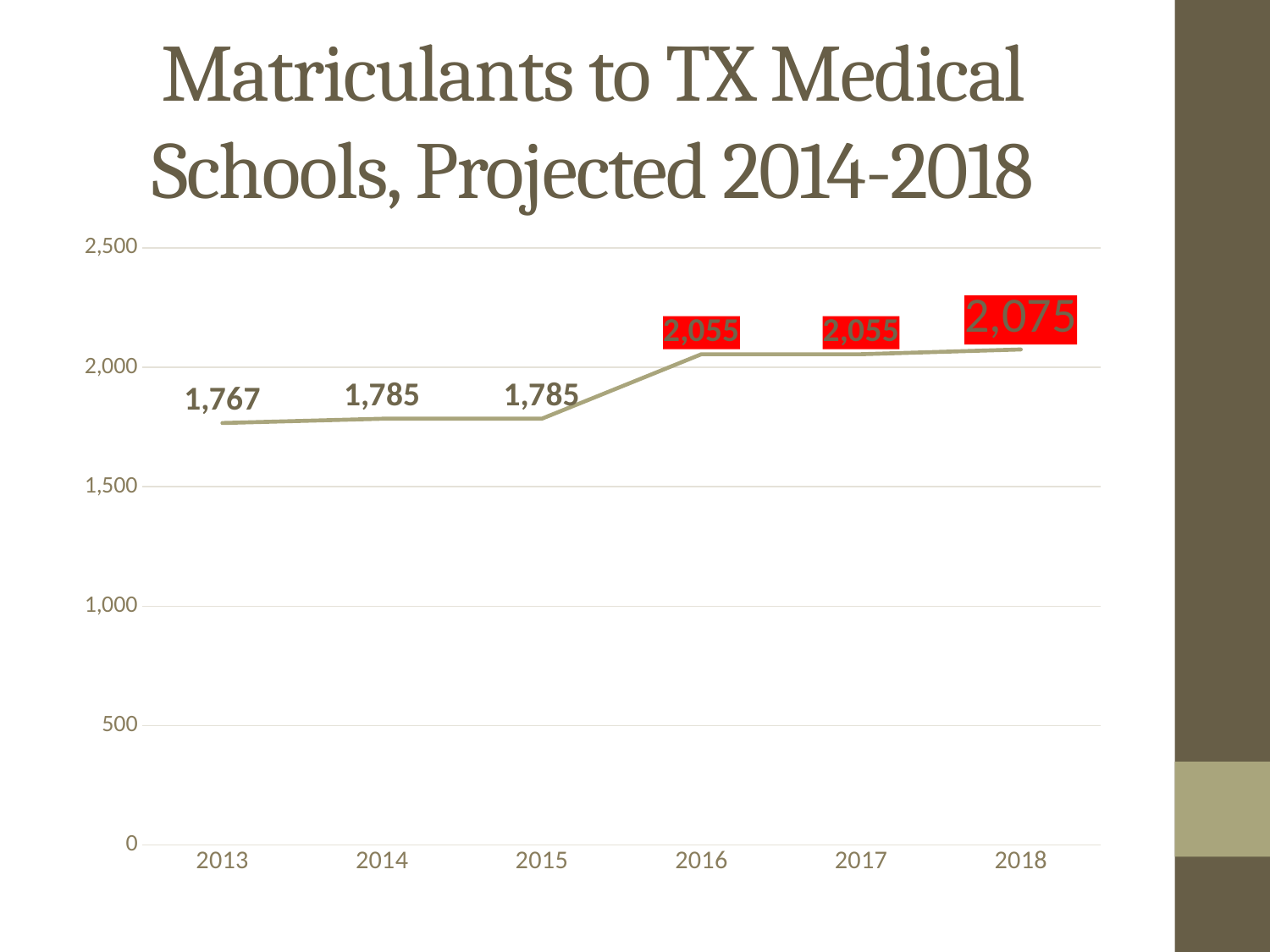
Which year has the highest value? 2018 What is the value for 2016? 2,055 Do the values generally rise or fall from 2013 to 2018? rise What is the difference between the values for 2018 and 2013? 308 What kind of chart is shown? line chart Is the value for 2015 greater or less than 2,000? less Which year has the lowest value? 2013 How many years are plotted on the x axis? 6 Which is larger, the value for 2014 or the value for 2017? 2017 What is the difference between the values for 2016 and 2015? 270 What is the value for 2018? 2,075 What is the value for 2013? 1,767